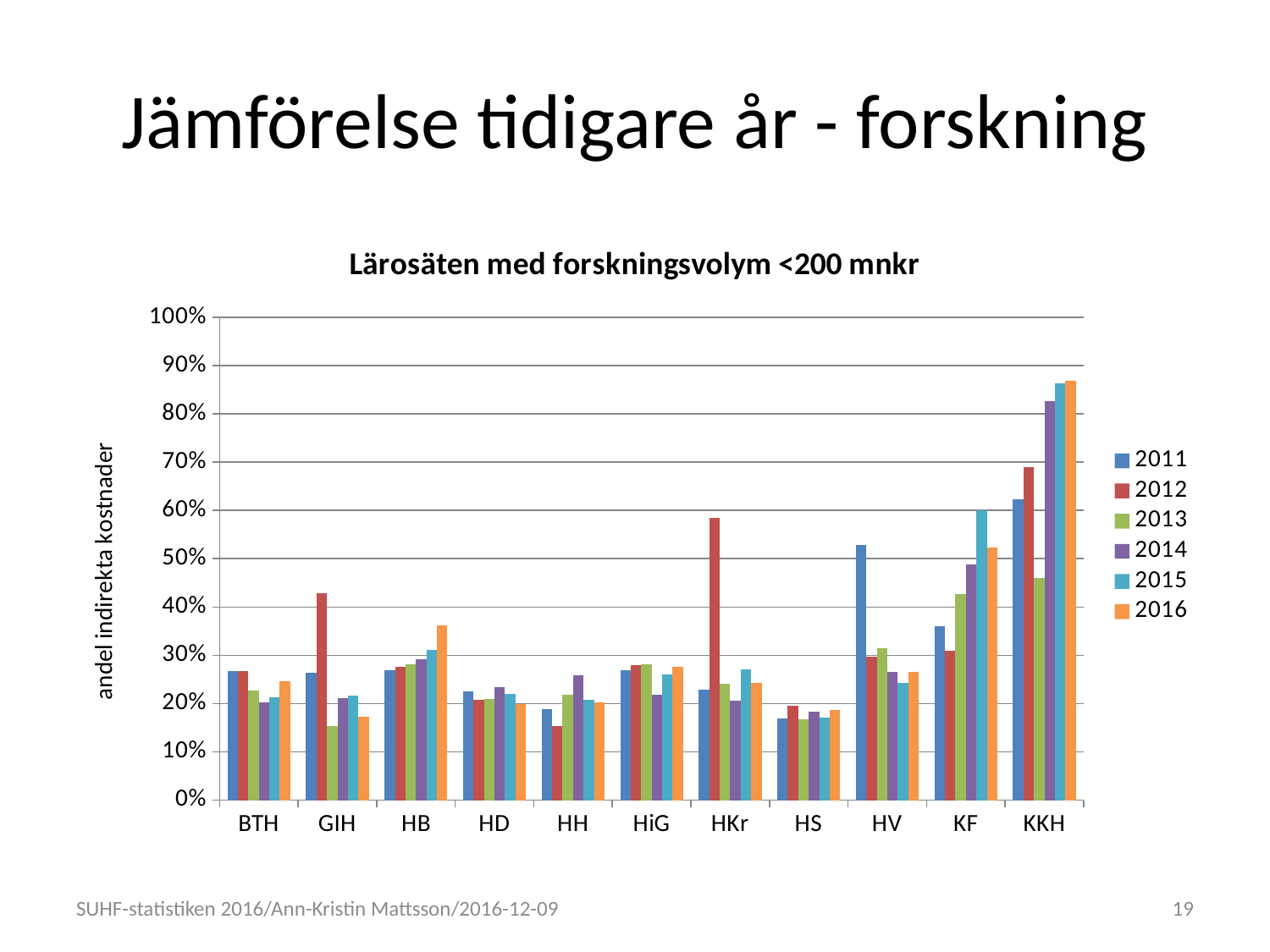
Is the value for HV in 2011 greater or less than 50%? greater Is the value for HS in 2011 greater or less than 20%? less Which is larger for KF: the 2011 value or the 2015 value? 2015 Which category has the lowest value for 2012? HH Is the value for KKH in 2016 greater or less than 80%? greater What kind of chart is shown on the slide? bar chart How many categories (lärosäten) are shown on the x axis? 11 What is the title of the chart? Lärosäten med forskningsvolym <200 mnkr Which is larger for GIH: the 2012 value or the 2013 value? 2012 Which category has the highest value for 2016? KKH Which category has the highest value for 2012? KKH How many series does the legend list? 6